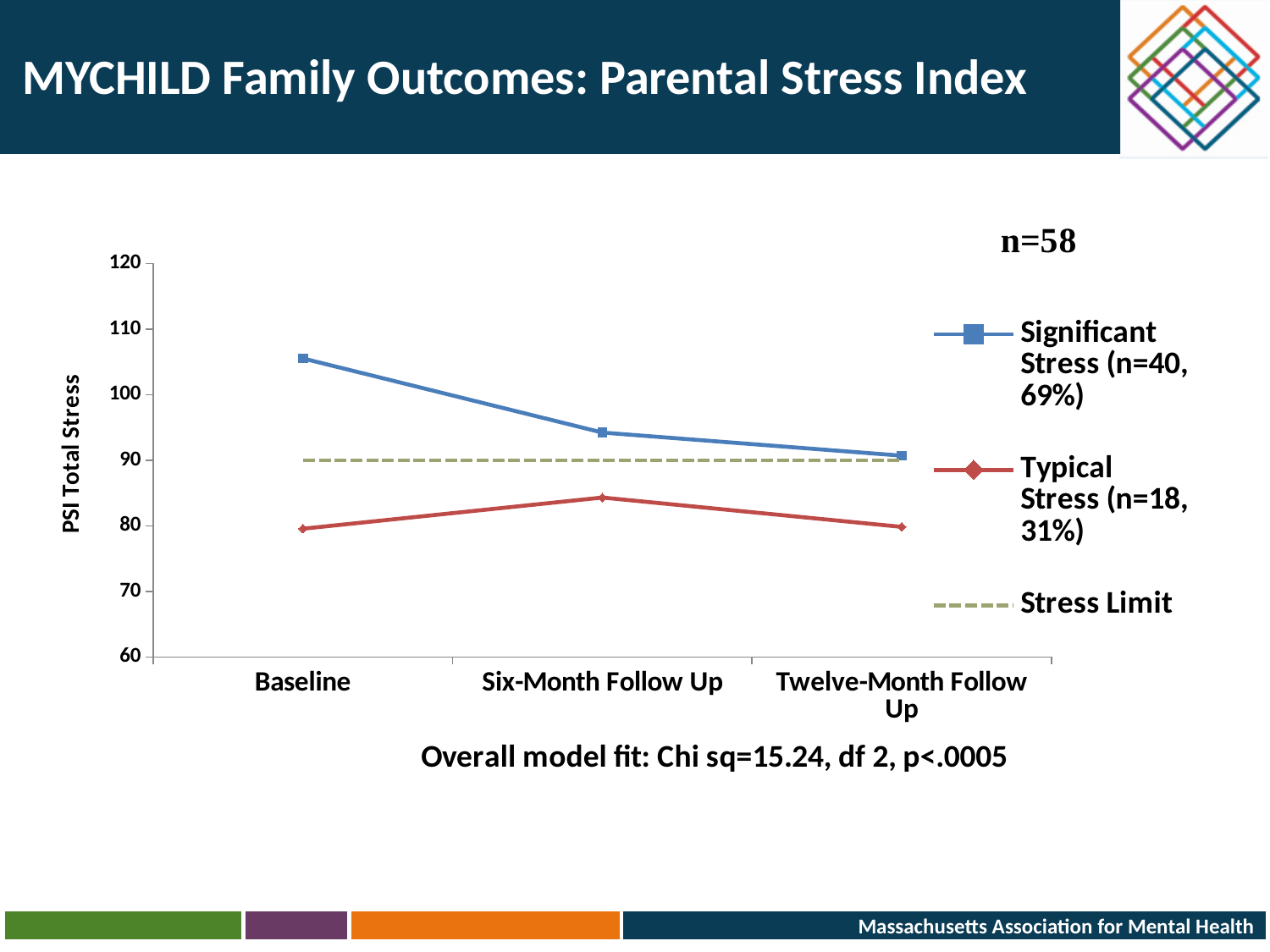
How many series does the legend list? 3 Is the Significant Stress value at Baseline greater or less than 100? greater Does the Significant Stress line rise or fall from Baseline to Twelve-Month Follow Up? Fall How many time points are shown on the x axis? 3 What is the label on the y axis of the chart? PSI Total Stress At which time point is the Significant Stress value lowest? Twelve-Month Follow Up At which time point is the Typical Stress value highest? Six-Month Follow Up Is the Typical Stress value at Six-Month Follow Up greater or less than 80? greater At which time point is the Significant Stress value highest? Baseline What kind of chart is shown on the slide? Line chart Is the Significant Stress value at Six-Month Follow Up greater or less than 100? less At Baseline, which is larger: Significant Stress or Typical Stress? Significant Stress